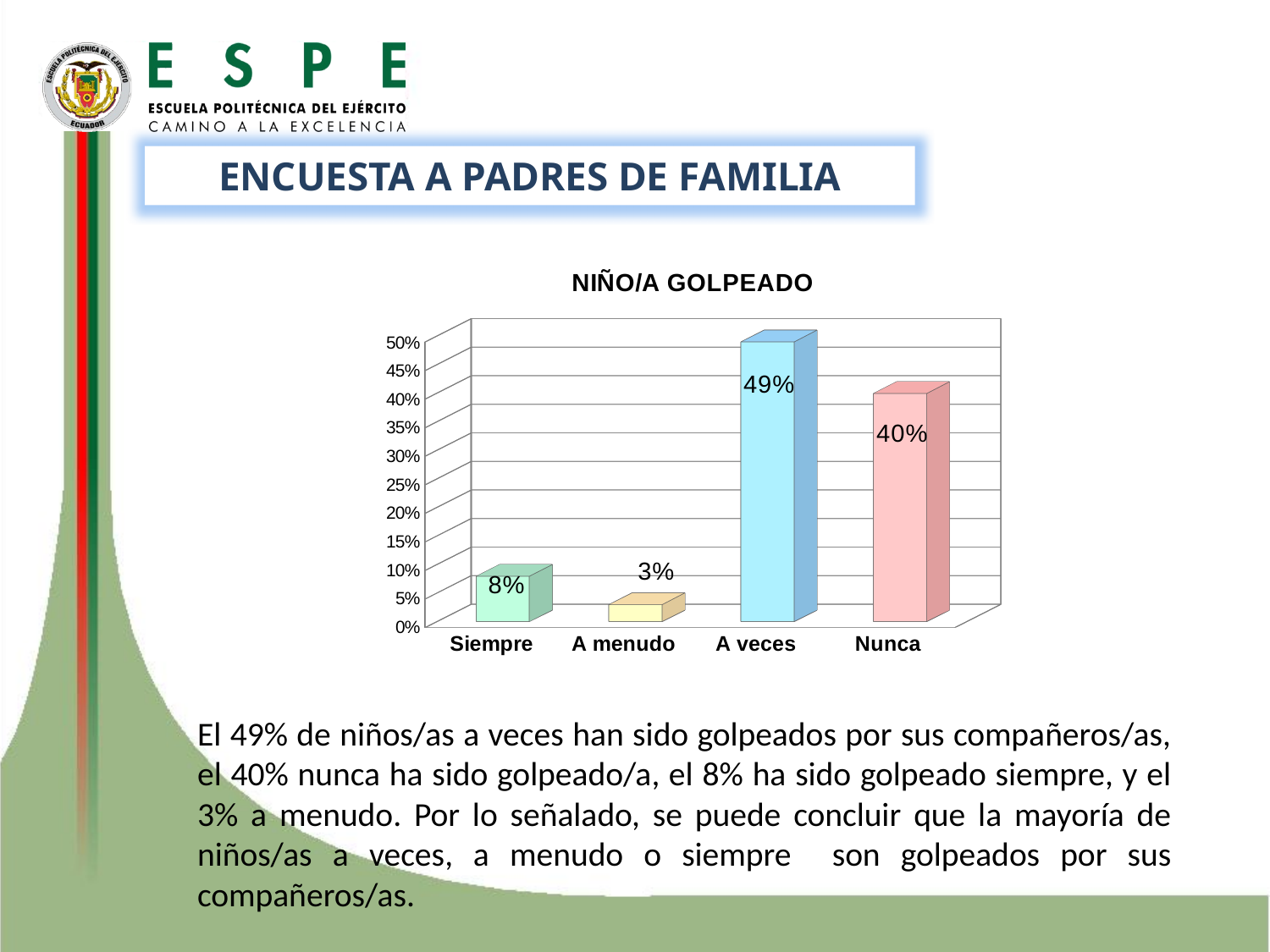
What is the value for 'Siempre' in the chart? 8% What is the value for 'Nunca' in the chart? 40% What is the value for 'A menudo' in the chart? 3% What is the difference between the values for 'Siempre' and 'A menudo'? 5% What kind of chart is shown on the slide? Bar chart Which category has the lowest value in the chart? A menudo What is the title of the chart? NIÑO/A GOLPEADO Which category has the highest value in the chart? A veces What is the difference between the values for 'A veces' and 'Nunca'? 9% Which is larger, the value for 'Siempre' or the value for 'A menudo'? Siempre What is the value for 'A veces' in the chart? 49% How many categories are shown in the chart? 4